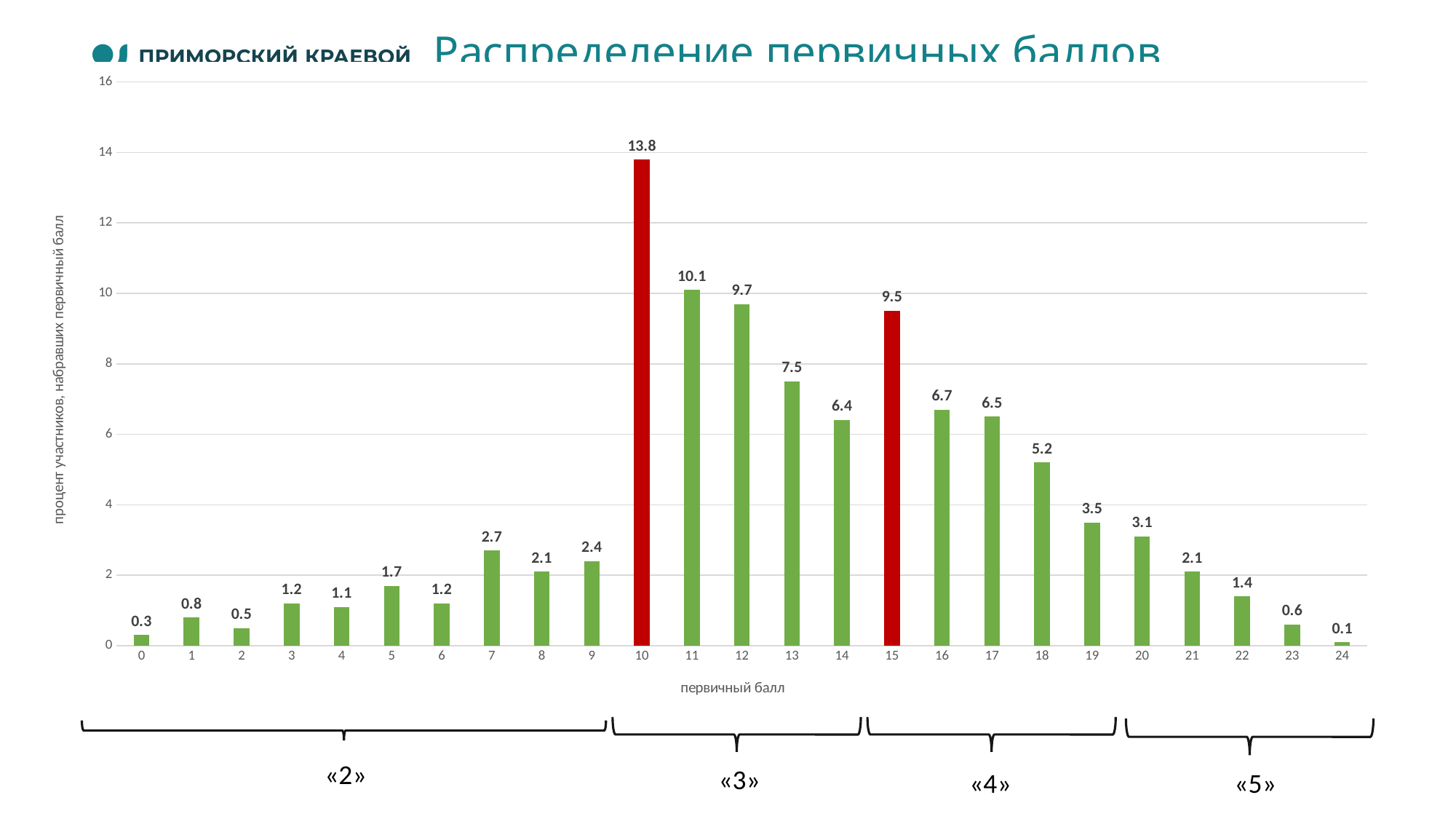
Which primary score has the lowest percentage of participants? 24 What is the value for primary score 15? 9.5 How many primary score categories are shown on the x axis? 25 What is the difference between the values for primary scores 10 and 11? 3.7 Which two bars are coloured red instead of green? 10 and 15 Which is larger, the value for primary score 13 or for primary score 16? 13 What kind of chart is shown on the slide? bar chart Which primary score has the highest percentage of participants? 10 What is the value for primary score 18? 5.2 Is the value for primary score 12 greater or less than 8? greater Do the values rise or fall along the x axis from primary score 15 to 24? fall What is the value for primary score 10? 13.8